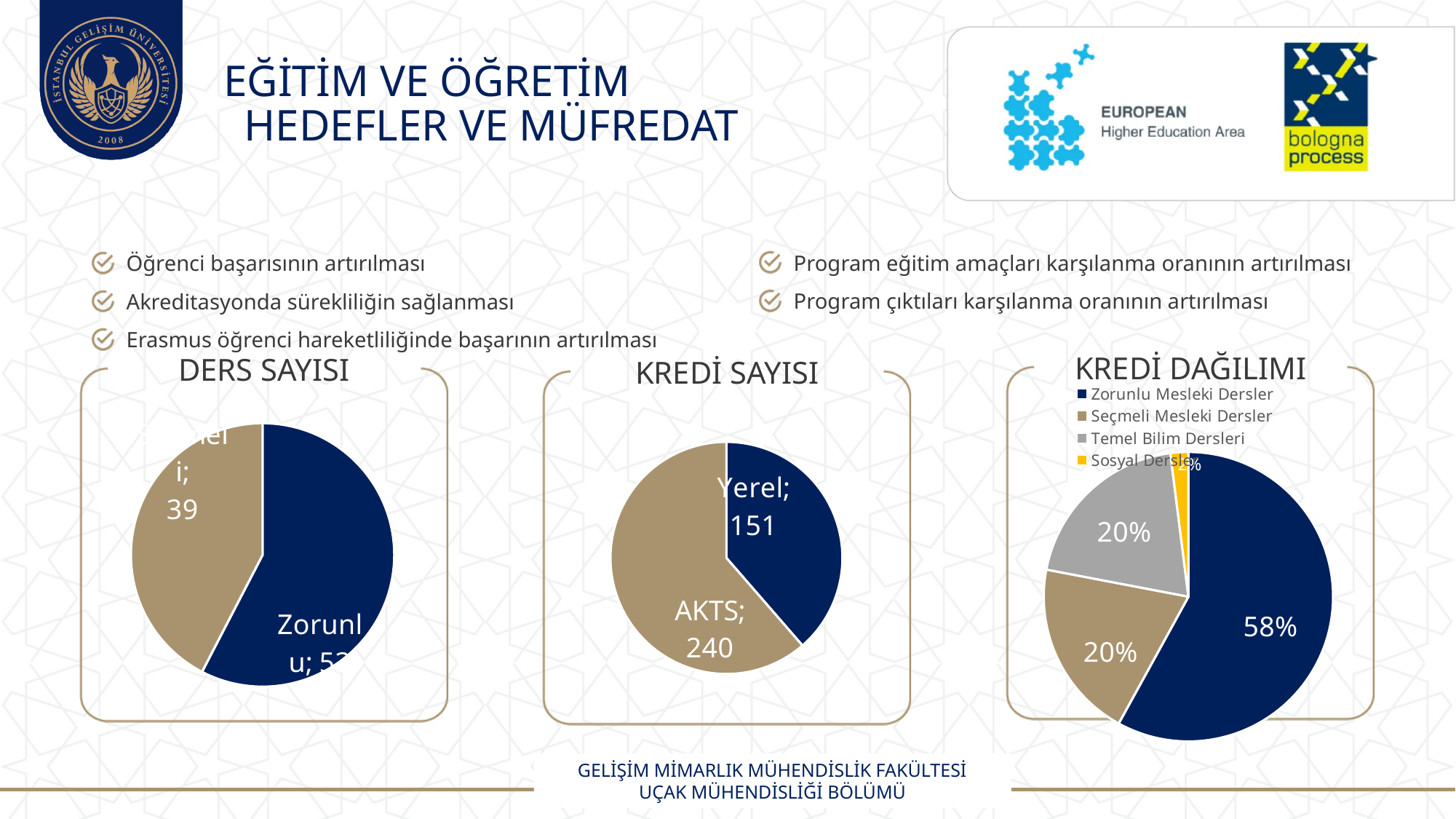
In the KREDİ DAĞILIMI chart, what share do Sosyal Dersler have? 2% In the KREDİ DAĞILIMI chart, which category has the smallest share? Sosyal Dersler In the KREDİ DAĞILIMI chart, which category has the largest share? Zorunlu Mesleki Dersler In the KREDİ SAYISI chart, which slice is larger, Yerel or AKTS? AKTS In the KREDİ DAĞILIMI chart, what is the difference in percentage points between Zorunlu Mesleki Dersler and Sosyal Dersler? 56 What kind of chart is the KREDİ SAYISI chart? Pie chart In the DERS SAYISI chart, which slice is larger, the Zorunlu slice or the other slice? Zorunlu How many categories does the legend of the KREDİ DAĞILIMI chart list? 4 In the KREDİ SAYISI chart, what is the value for Yerel? 151 In the KREDİ SAYISI chart, what is the value for AKTS? 240 In the KREDİ SAYISI chart, what is the difference between the AKTS and Yerel values? 89 In the KREDİ DAĞILIMI chart, what share do Zorunlu Mesleki Dersler have? 58%